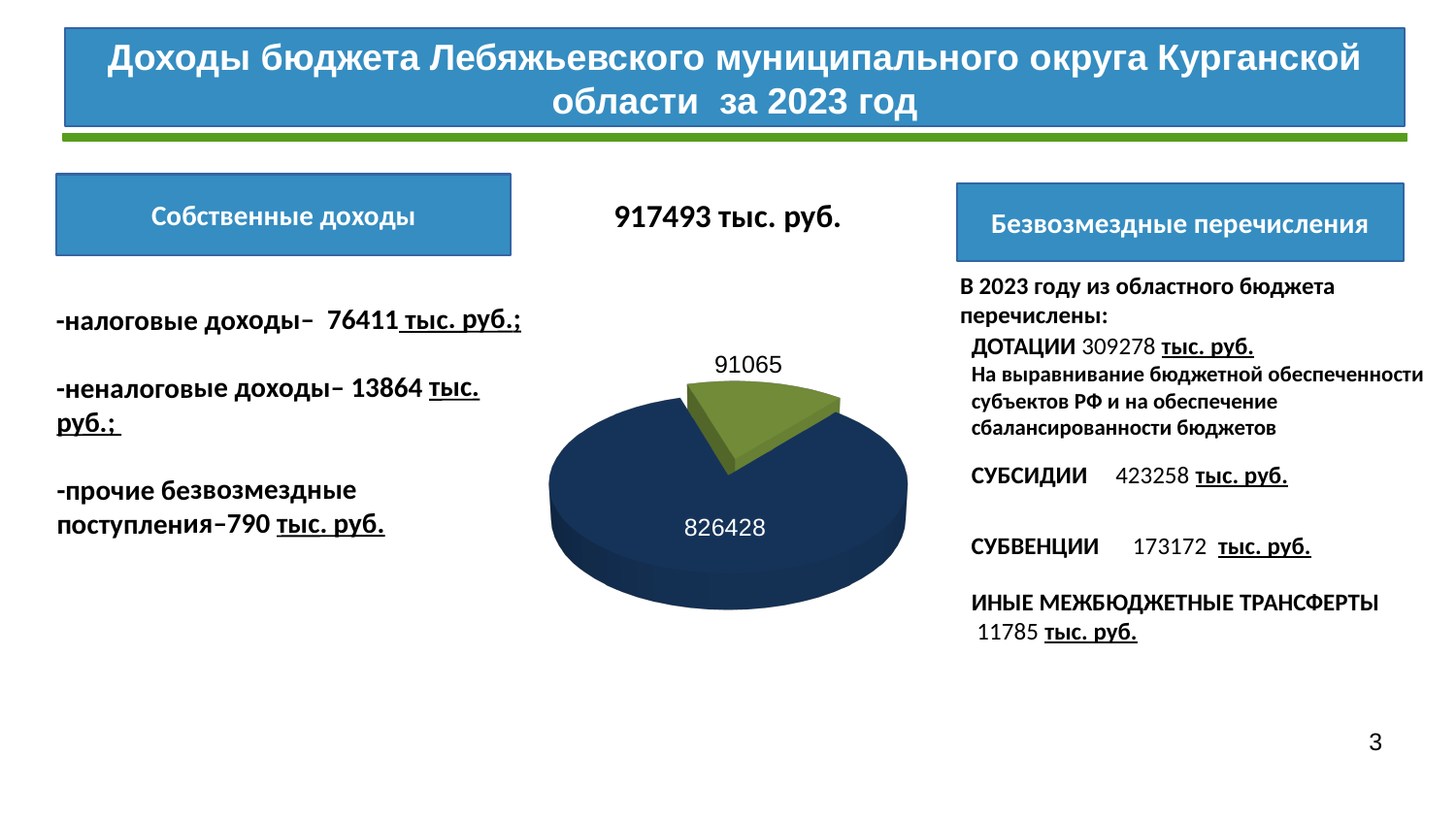
Which slice of the pie chart is the smallest? the green slice (91065) What colour is the slice labelled 826428? dark blue What kind of chart is shown on the slide? pie chart What is the difference between the two values shown on the pie chart, 826428 and 91065? 735363 What is the total of the two values shown on the pie chart? 917493 Which is larger on the pie chart: the green slice or the dark blue slice? the dark blue slice How many slices does the pie chart have? 2 What value is labelled on the large dark blue slice of the pie chart? 826428 Does the pie chart have a legend? No What value is labelled on the small green slice of the pie chart? 91065 What share of the pie does the green slice (91065) represent? 9.9% Which slice of the pie chart is the largest? the dark blue slice (826428)